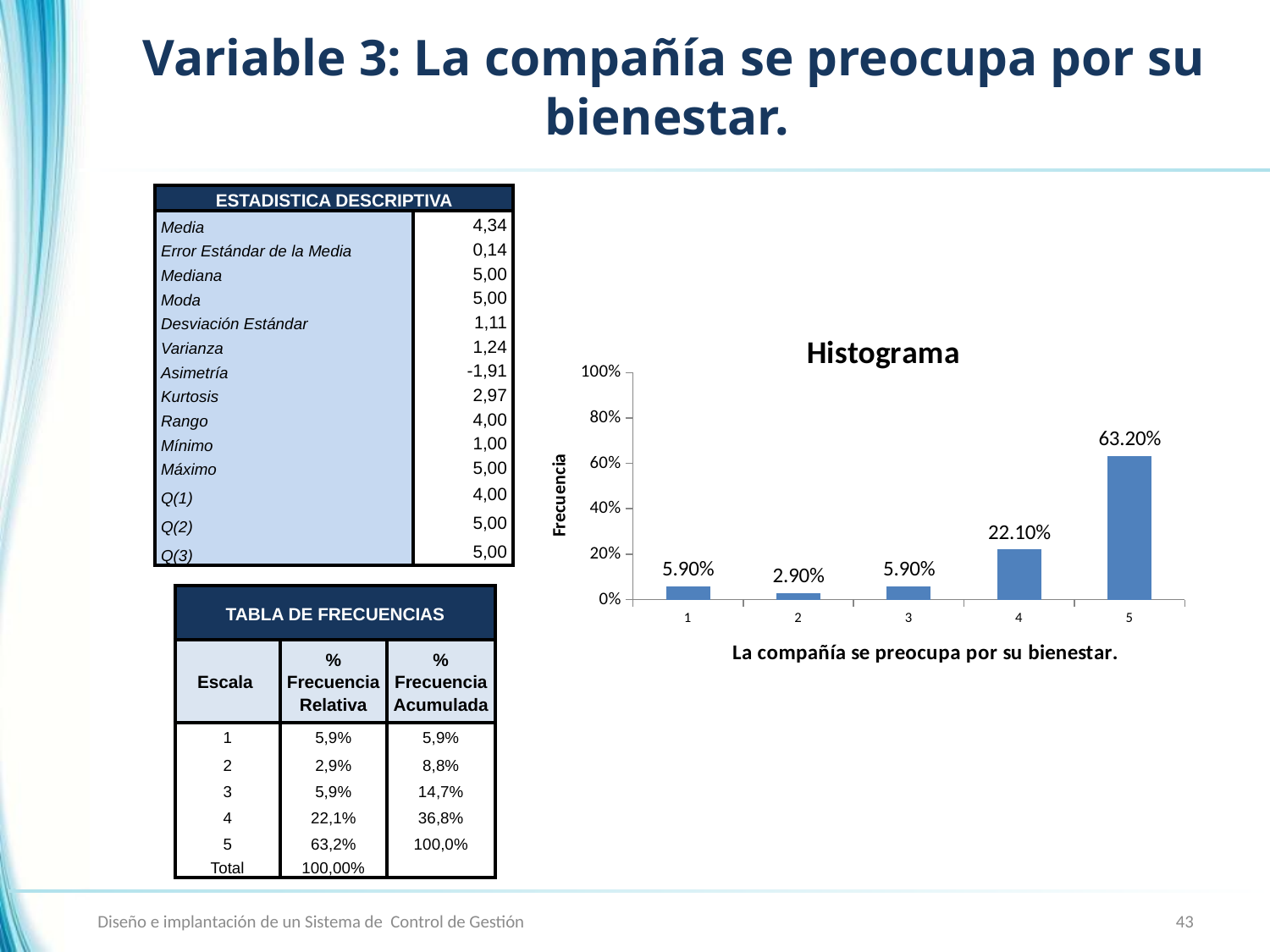
Which category has the highest value in the histogram? 5 What kind of chart is the histogram? bar chart What is the label of the y axis of the chart? Frecuencia Is the value for category 5 in the histogram greater or less than 60%? greater Which is larger in the histogram, the value for category 3 or the value for category 4? 4 What is the value for category 2 in the histogram? 2.90% Which category has the lowest value in the histogram? 2 What is the value for category 5 in the histogram? 63.20% What is the value for category 4 in the histogram? 22.10% How many categories are shown on the x axis of the histogram? 5 What is the title of the chart? Histograma What is the difference between the values for category 5 and category 4 in the histogram? 41.10%